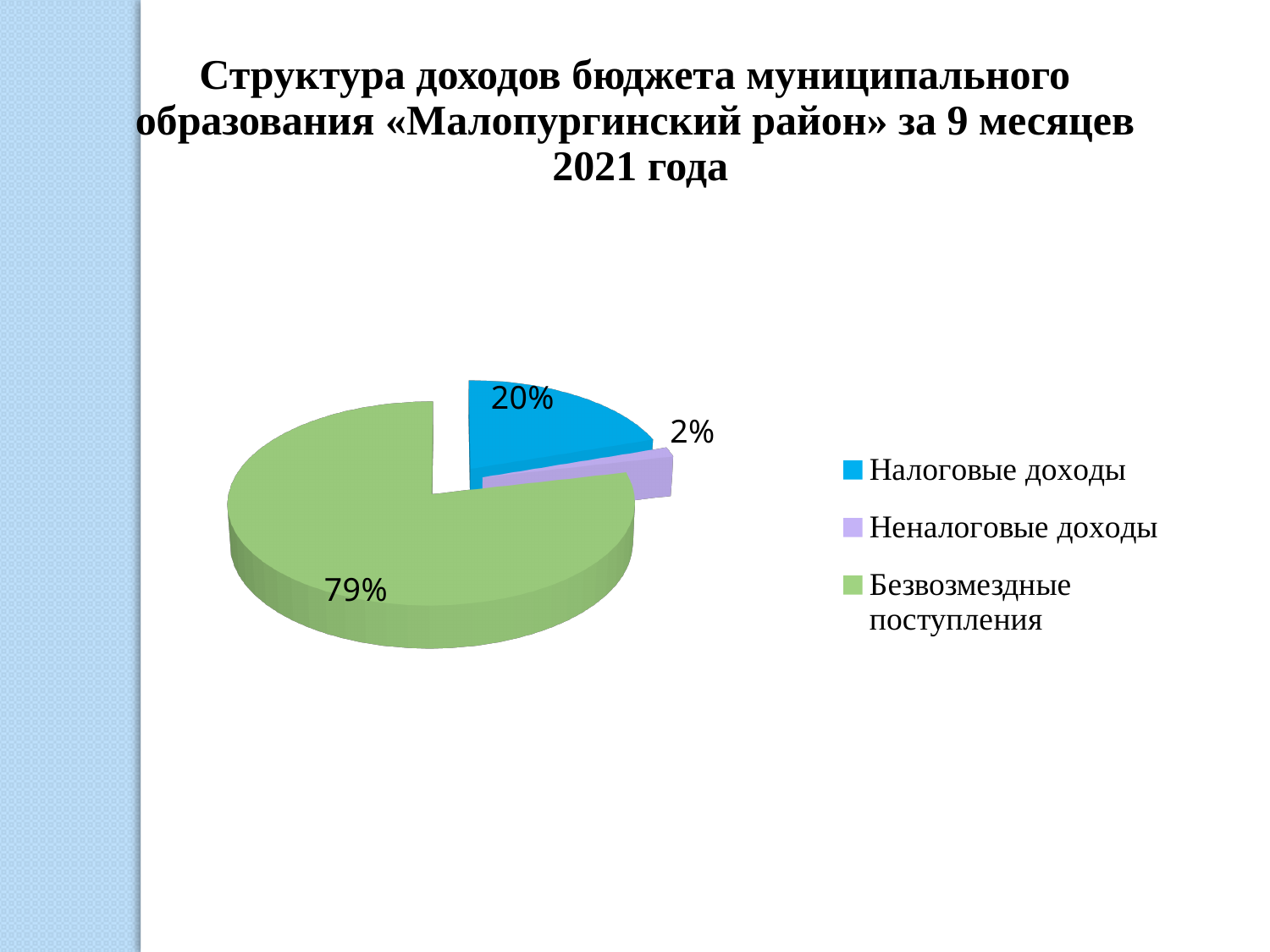
Which is larger, Налоговые доходы or Неналоговые доходы? Налоговые доходы What share of the pie does Безвозмездные поступления have? 79% What colour is the slice for Безвозмездные поступления? green Which category has the smallest slice of the pie? Неналоговые доходы Which category has the largest slice of the pie? Безвозмездные поступления What is the difference in percentage points between Безвозмездные поступления and Налоговые доходы? 59 What share of the pie does Налоговые доходы have? 20% Which legend entry is shown in blue? Налоговые доходы What share of the pie does Неналоговые доходы have? 2% How many categories does the pie chart show? 3 What kind of chart is shown on the slide? pie chart What is the difference in percentage points between Налоговые доходы and Неналоговые доходы? 18